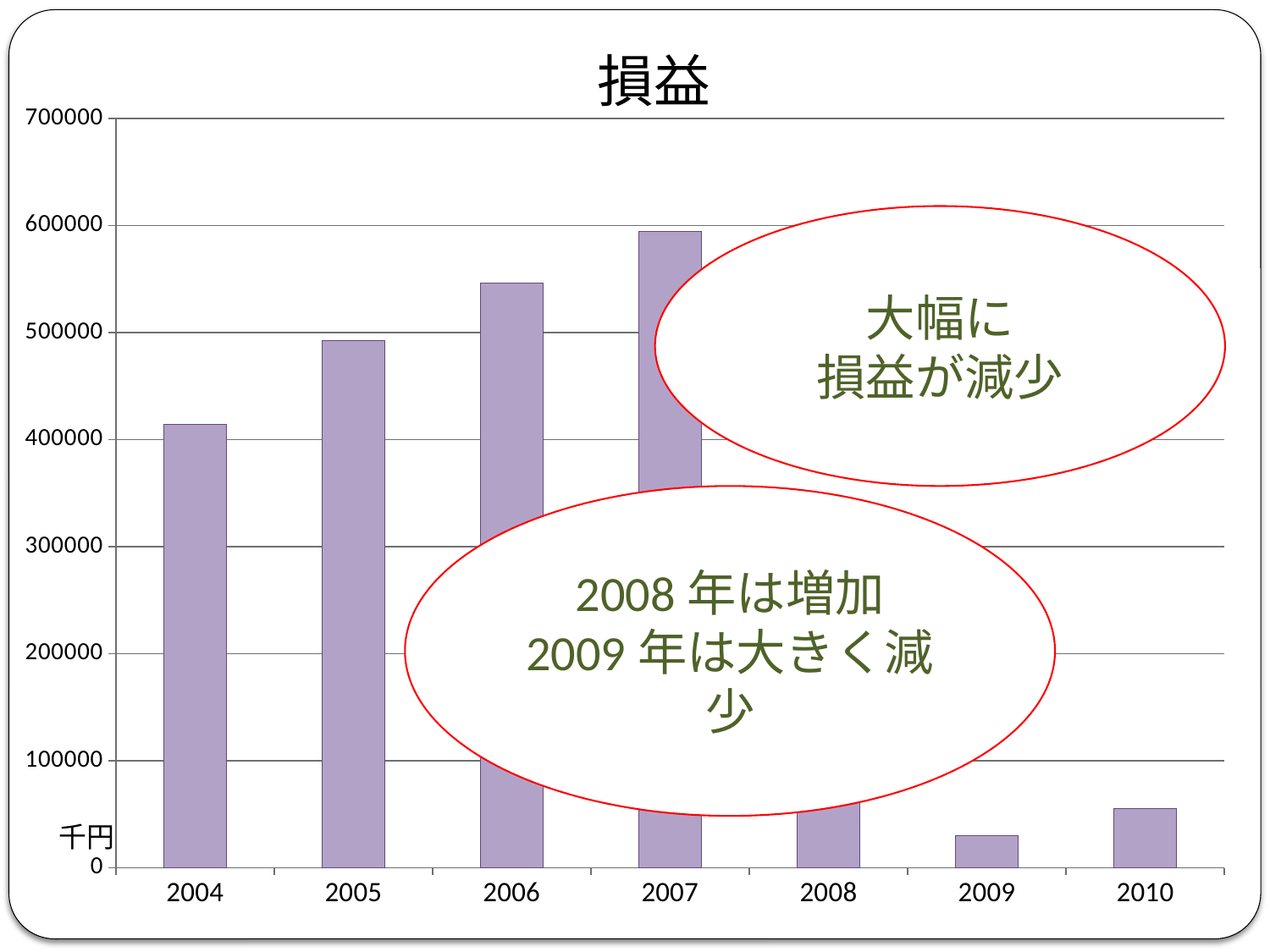
Do the values rise or fall from 2004 to 2007? rise Which year has the highest value? 2007 Is the value for 2006 greater or less than 500000? greater What kind of chart is shown on the slide? bar chart Is the value for 2004 greater or less than 400000? greater Which is larger, the value for 2005 or the value for 2006? 2006 How many years (categories) are plotted on the x axis? 7 Is the value for 2005 greater or less than 500000? less What unit label is shown next to the vertical axis? 千円 What is the title of the chart? 損益 Which year has the lowest value? 2009